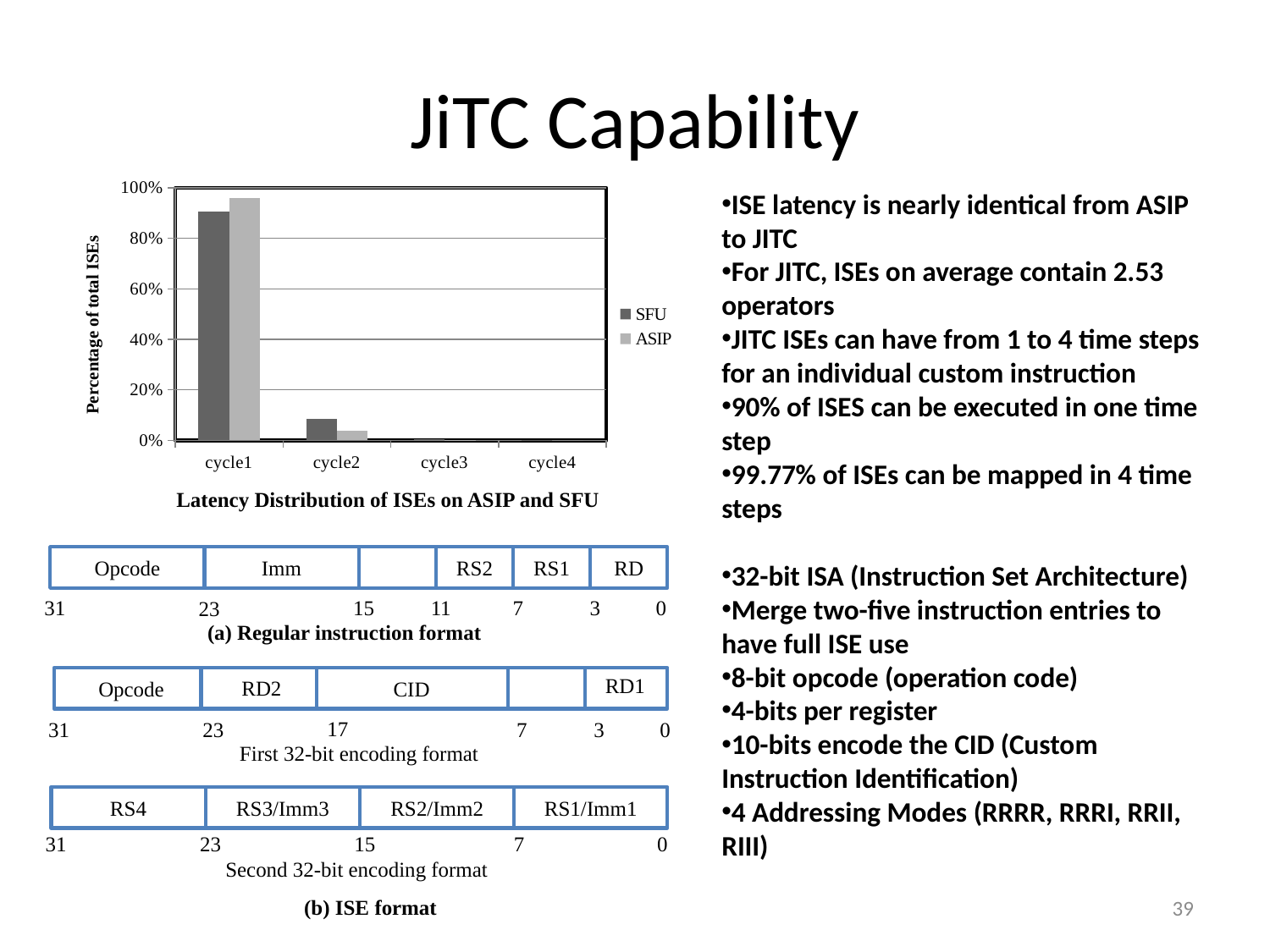
What is the title of the chart? Latency Distribution of ISEs on ASIP and SFU Which category has the highest value for the SFU series? cycle1 Is the SFU value for cycle2 greater or less than 20%? less For cycle2, which series has the larger value, SFU or ASIP? SFU How many series does the chart's legend list? 2 Is the SFU value for cycle1 greater or less than 80%? greater What kind of chart is shown on the slide? bar chart How many categories are shown on the x axis of the chart? 4 Which category has the highest value for the ASIP series? cycle1 Do the values rise or fall from cycle1 to cycle4? fall Is the ASIP value for cycle1 greater or less than 80%? greater For cycle1, which series has the larger value, SFU or ASIP? ASIP